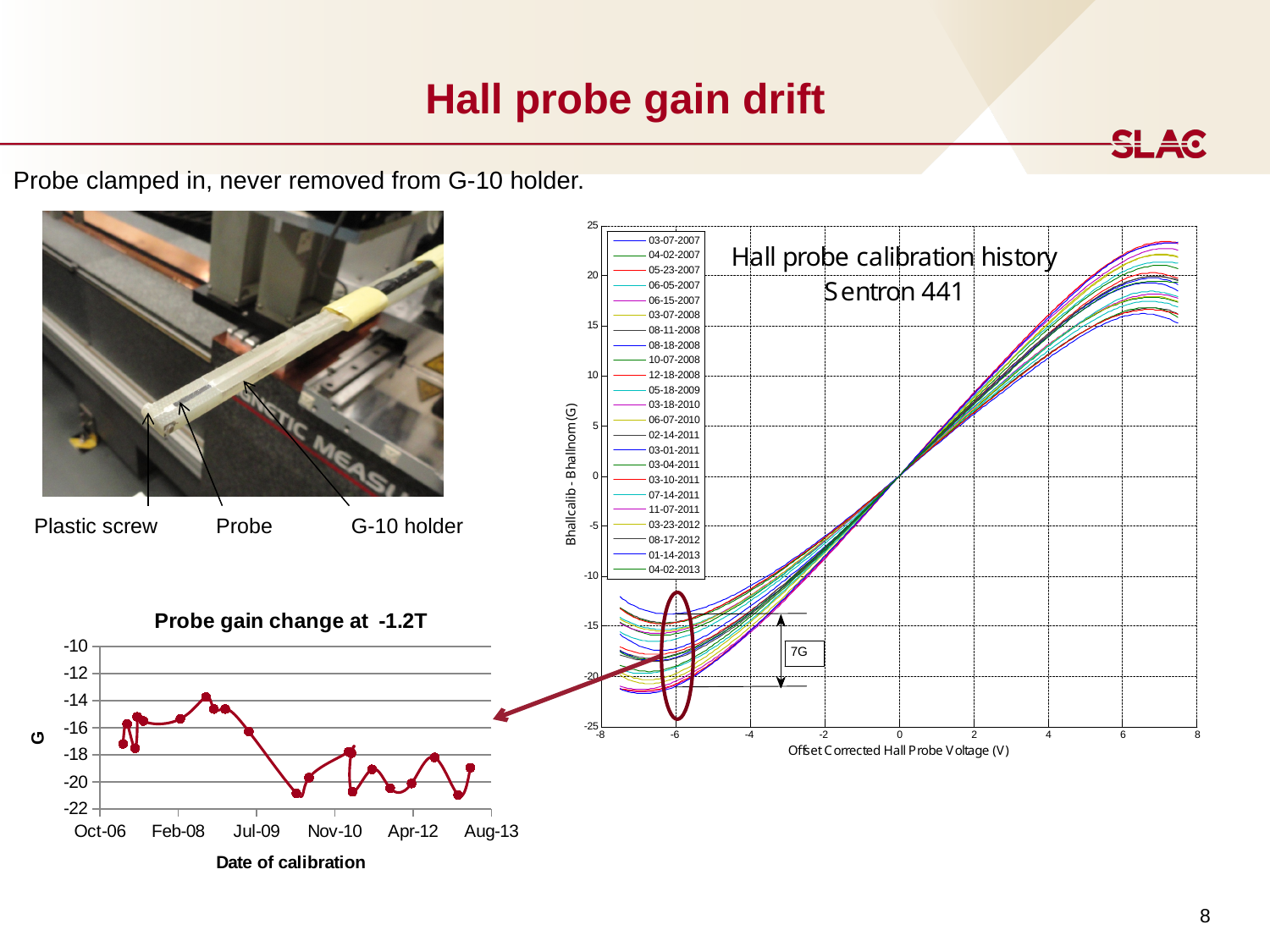
In the 'Probe gain change at -1.2T' chart, what is the label of the x axis? Date of calibration In the 'Probe gain change at -1.2T' chart, is the highest plotted value greater or less than -16? greater What kind of chart is the 'Hall probe calibration history' chart? line chart What kind of chart is the 'Probe gain change at -1.2T' chart? line chart In the 'Hall probe calibration history' chart, what is the first date listed in the legend? 03-07-2007 In the 'Hall probe calibration history' chart, do the curves rise or fall as the voltage increases from -8 V to 8 V? rise In the 'Probe gain change at -1.2T' chart, is the lowest plotted value greater or less than -20? less In the 'Hall probe calibration history' chart, what is the label of the x axis? Offset Corrected Hall Probe Voltage (V) In the 'Hall probe calibration history' chart, what spread between curves is marked by the annotation near -6 V? 7G How many series does the legend of the 'Hall probe calibration history' chart list? 23 In the 'Hall probe calibration history' chart, what value do the curves take at 0 V? 0 In the 'Probe gain change at -1.2T' chart, do the values rise or fall between the peak in early 2008 and the low point in early 2010? fall